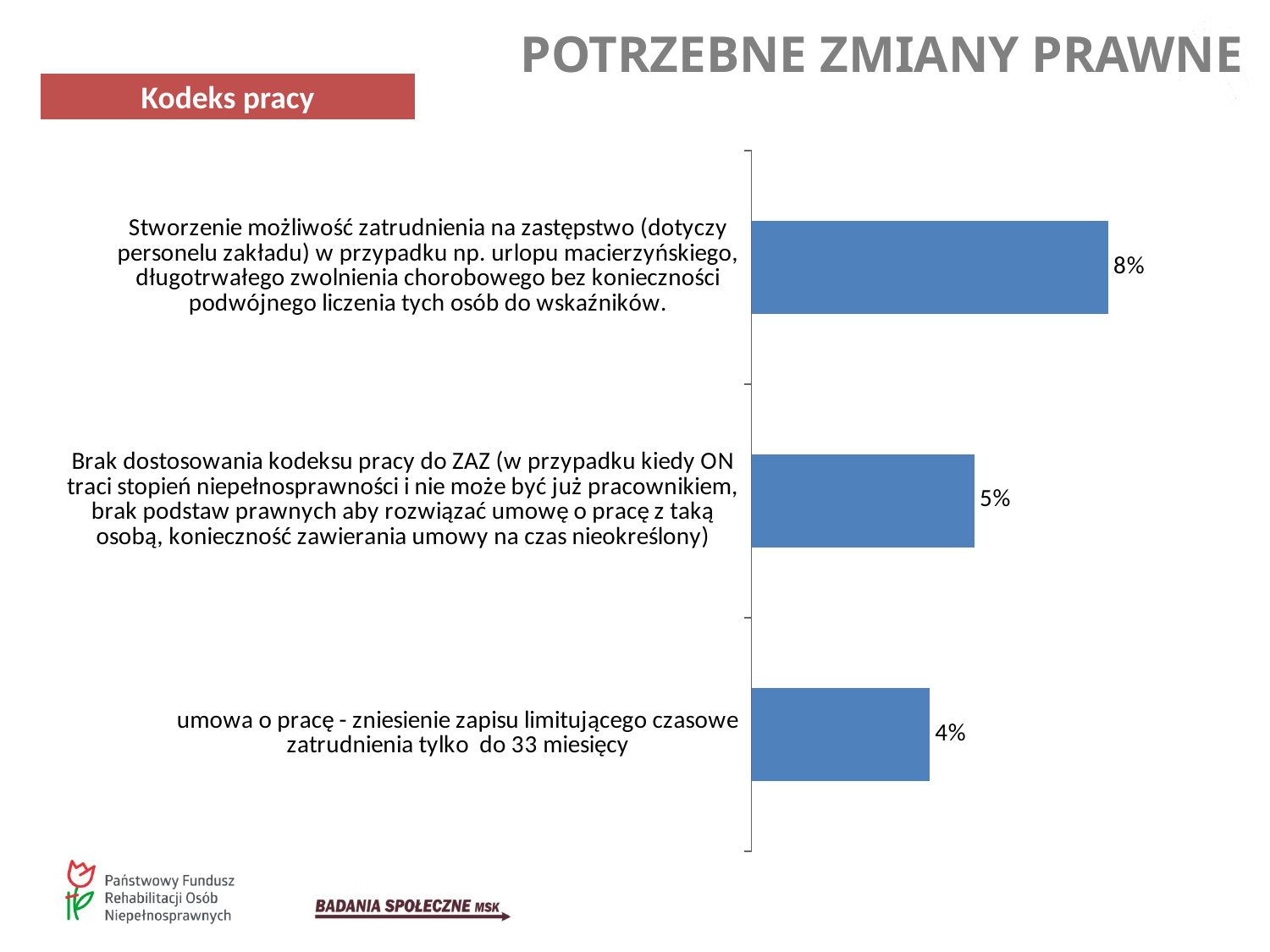
Which category has the lowest value? umowa o pracę - zniesienie zapisu limitującego czasowe zatrudnienia tylko do 33 miesięcy How many categories are shown in the chart? 3 What is the difference between the highest value (8%) and the lowest value (4%)? 4% What is the heading shown in the red box above the chart? Kodeks pracy What is the value for the category 'Brak dostosowania kodeksu pracy do ZAZ...'? 5% What kind of chart is shown on the slide? Bar chart Which is larger: the value for 'Brak dostosowania kodeksu pracy do ZAZ...' or the value for 'umowa o pracę - zniesienie zapisu...'? Brak dostosowania kodeksu pracy do ZAZ... What is the value for the category 'umowa o pracę - zniesienie zapisu limitującego czasowe zatrudnienia tylko do 33 miesięcy'? 4% What is the difference between the value for 'Brak dostosowania kodeksu pracy do ZAZ...' and the value for 'umowa o pracę - zniesienie zapisu...'? 1% What is the value for the category about creating the possibility of replacement employment (Stworzenie możliwość zatrudnienia na zastępstwo...)? 8% What colour are the bars in the chart? Blue